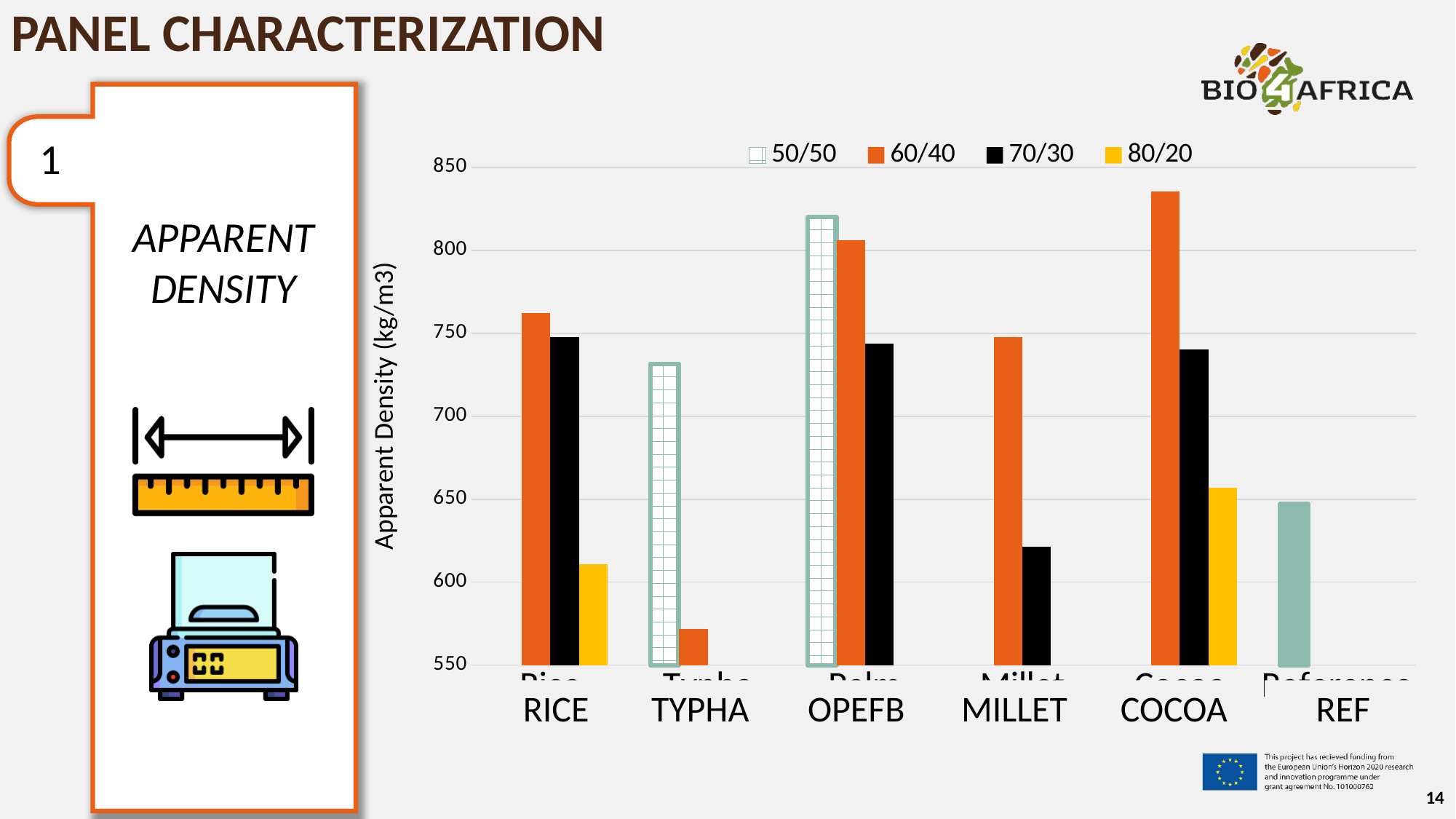
What is the label of the y axis of the chart? Apparent Density (kg/m3) Which category has the highest 60/40 apparent density? COCOA Is the 60/40 apparent density for RICE greater or less than 750? greater What kind of chart is shown on the slide? bar chart Which is larger, the 50/50 apparent density for TYPHA or for OPEFB? OPEFB Is the 60/40 apparent density for TYPHA greater or less than 600? less Is the 70/30 apparent density for MILLET greater or less than 650? less Which category has the lowest 60/40 apparent density? TYPHA How many series does the chart legend list? 4 Which is larger, the 80/20 apparent density for RICE or for COCOA? COCOA How many material categories are shown along the x axis of the chart? 6